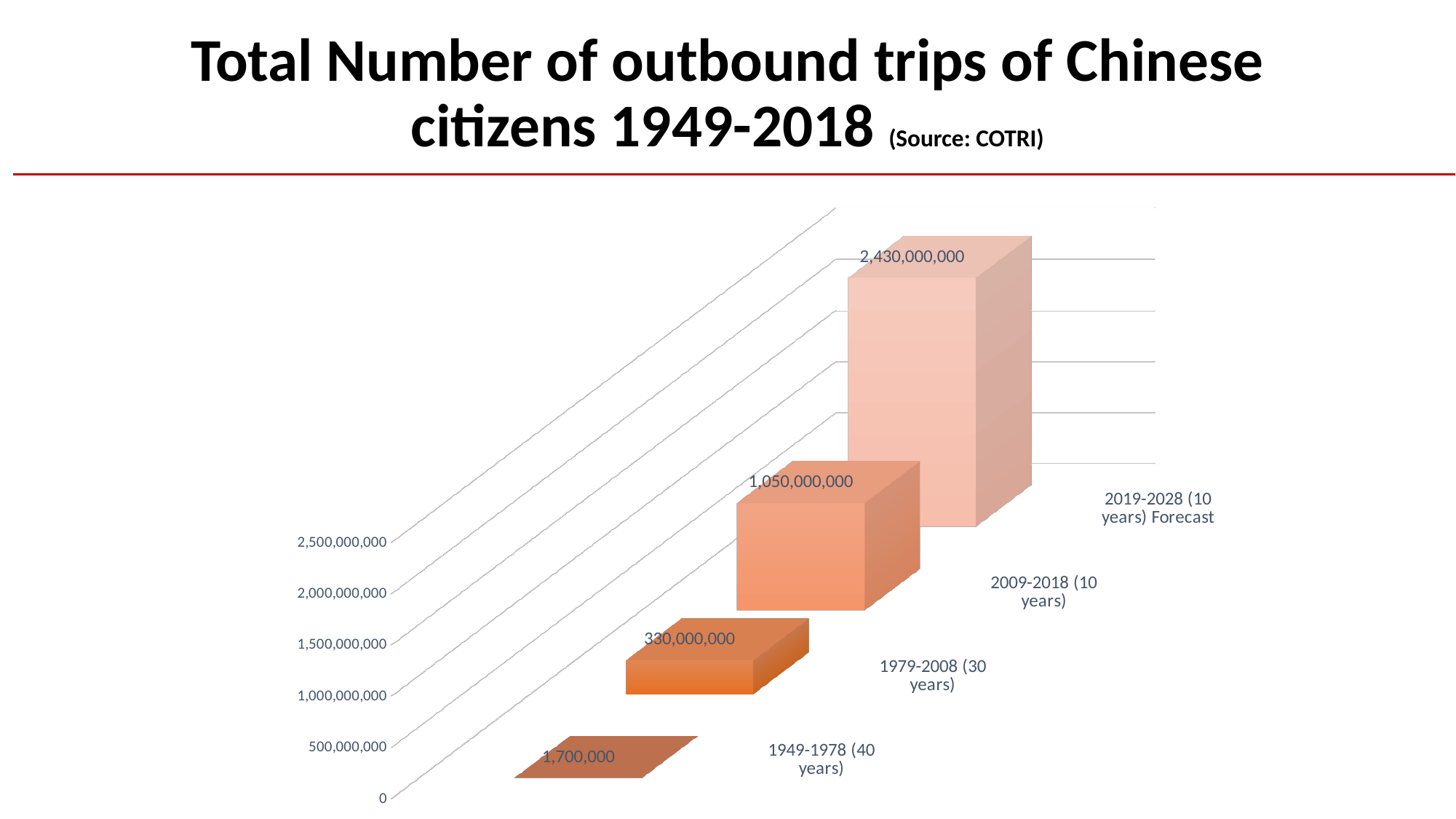
What is the difference between the values for 2019-2028 (10 years) Forecast and 2009-2018 (10 years)? 1,380,000,000 What is the value for 1979-2008 (30 years)? 330,000,000 What is the value for 1949-1978 (40 years)? 1,700,000 Which is larger, the value for 1979-2008 (30 years) or the value for 2009-2018 (10 years)? 2009-2018 (10 years) Do the values rise or fall from 1949-1978 to 2019-2028? Rise What is the difference between the values for 2009-2018 (10 years) and 1979-2008 (30 years)? 720,000,000 How many periods are shown in the chart? 4 Which period has the highest value? 2019-2028 (10 years) Forecast Which period has the lowest value? 1949-1978 (40 years) What kind of chart is shown on the slide? Bar chart What is the value for 2009-2018 (10 years)? 1,050,000,000 What is the value for 2019-2028 (10 years) Forecast? 2,430,000,000